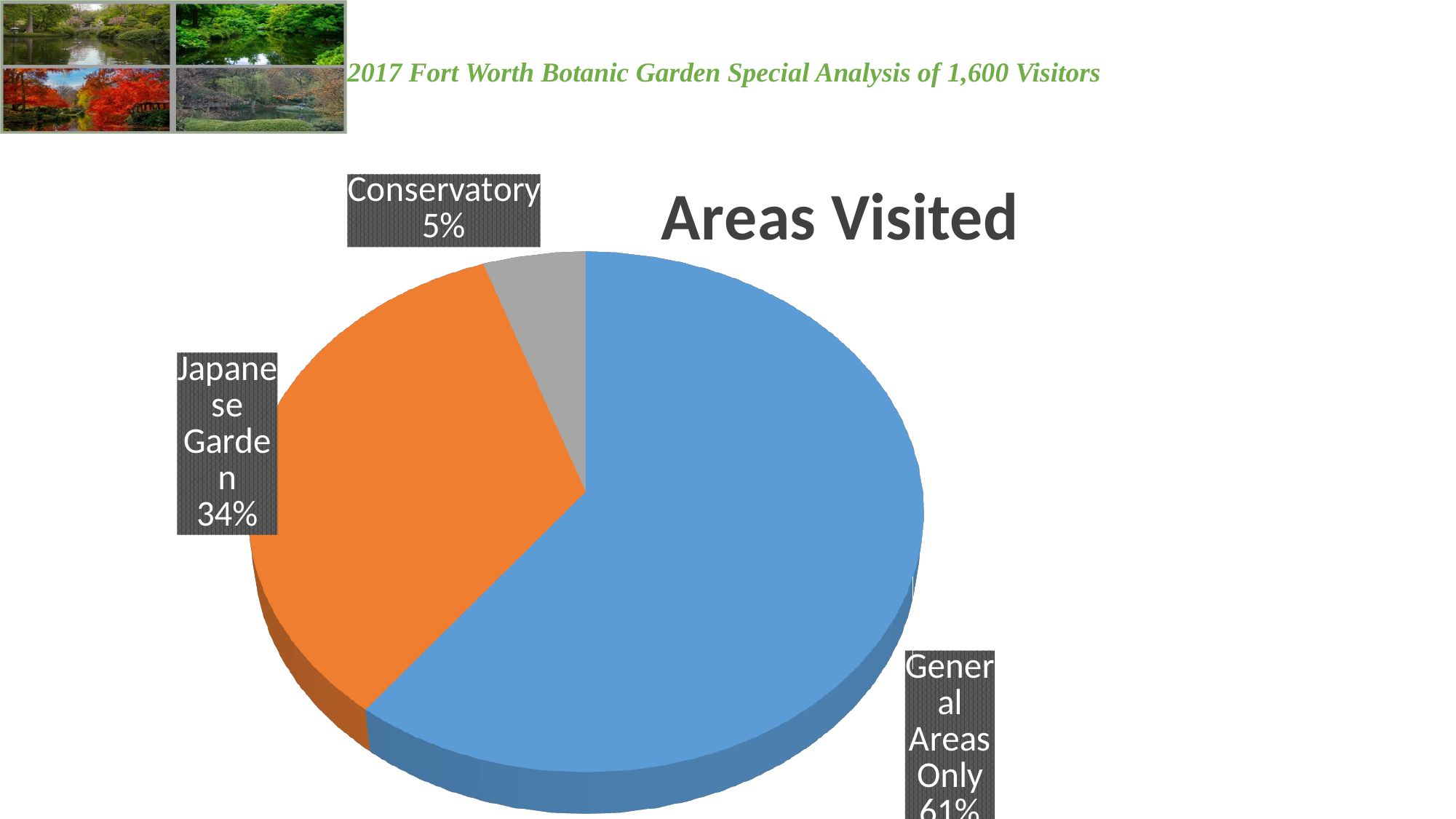
What colour is the slice for General Areas Only? blue What percentage of visitors visited the Japanese Garden? 34% Which area has the largest share of the pie? General Areas Only What percentage of visitors visited the Conservatory? 5% Which is larger, the share for Japanese Garden or the share for Conservatory? Japanese Garden Which area has the smallest share of the pie? Conservatory What is the difference in percentage points between General Areas Only and Japanese Garden? 27 How many slices does the pie chart have? 3 What type of chart is shown on the slide? pie chart What is the title of the chart? Areas Visited What is the difference in percentage points between Japanese Garden and Conservatory? 29 What percentage of visitors visited General Areas Only? 61%